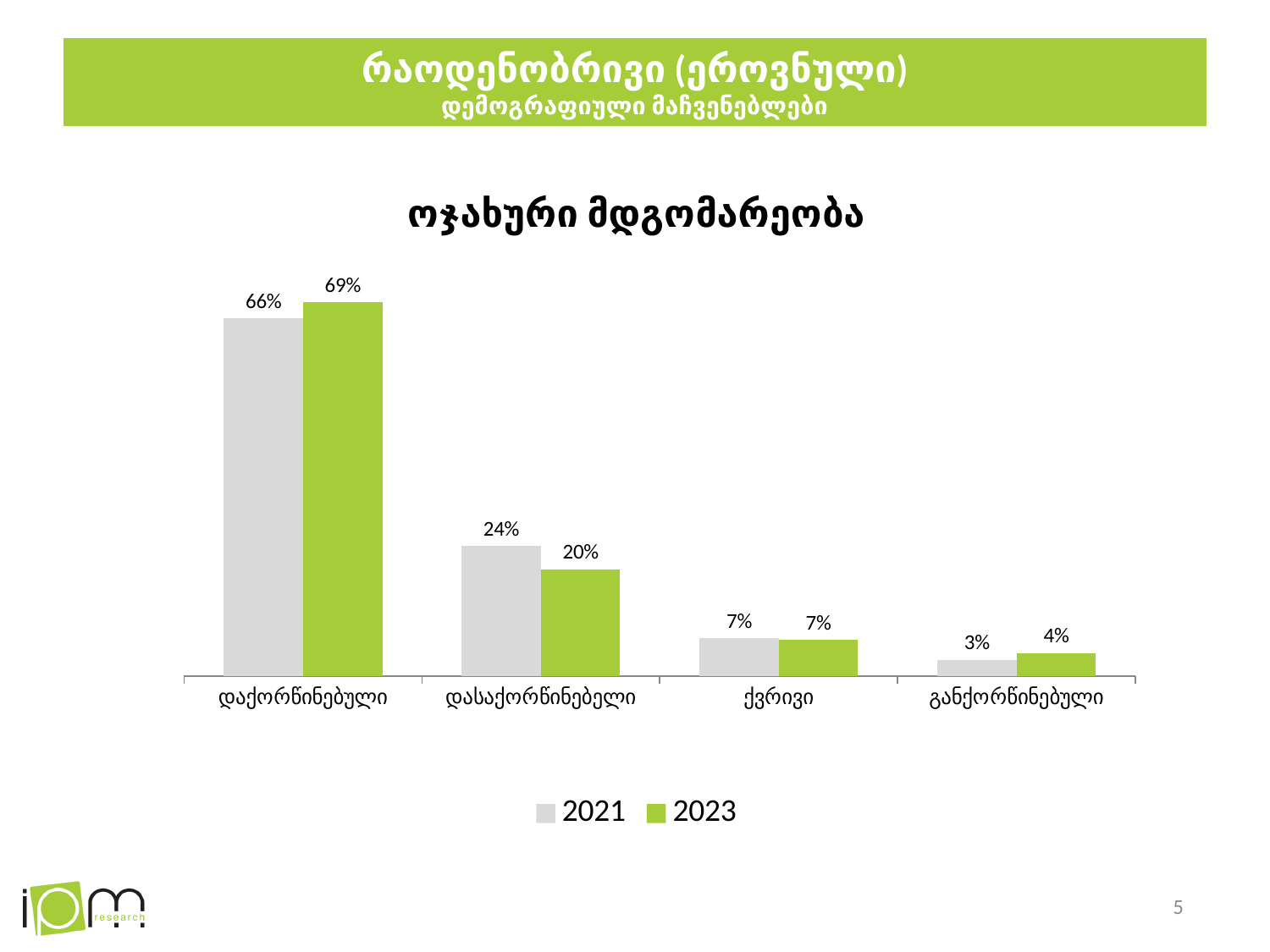
How many series does the legend list? 2 What is the value for განქორწინებული in 2021? 3% What is the difference between the 2023 and 2021 values for დაქორწინებული? 3% What is the value for ქვრივი in 2023? 7% Which category has the lowest value in 2021? განქორწინებული Which is larger for დასაქორწინებელი: the 2021 value or the 2023 value? 2021 What kind of chart is shown on the slide? bar chart What is the difference between the 2021 and 2023 values for დასაქორწინებელი? 4% What is the value for დაქორწინებული in 2023? 69% What is the value for დასაქორწინებელი in 2021? 24% Which category has the highest value in 2023? დაქორწინებული How many categories are shown on the x axis? 4